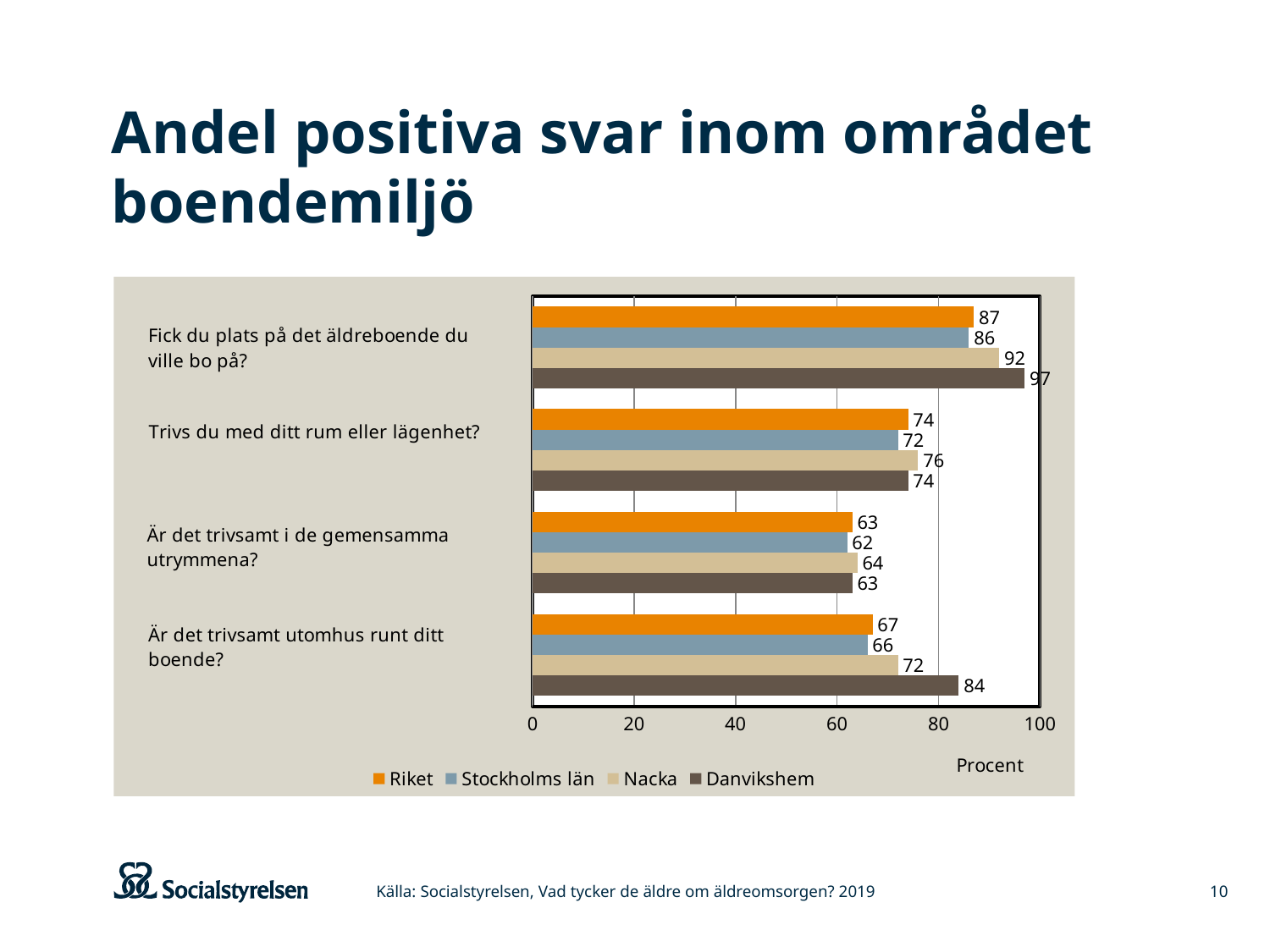
What kind of chart is shown on the slide? bar chart Is the value for Danvikshem on "Är det trivsamt i de gemensamma utrymmena?" greater or less than 80? less What is the difference between Danvikshem and Riket on "Är det trivsamt utomhus runt ditt boende?"? 17 How many series does the legend list? 4 Which is larger on "Trivs du med ditt rum eller lägenhet?": Nacka or Stockholms län? Nacka What is the value for Stockholms län on "Trivs du med ditt rum eller lägenhet?"? 72 How many questions (categories) are shown on the chart? 4 Which series has the highest value on "Är det trivsamt utomhus runt ditt boende?"? Danvikshem What is the value for Nacka on "Är det trivsamt utomhus runt ditt boende?"? 72 Which series has the lowest value on "Fick du plats på det äldreboende du ville bo på?"? Stockholms län What is the value for Danvikshem on "Fick du plats på det äldreboende du ville bo på?"? 97 What is the value for Riket on "Är det trivsamt i de gemensamma utrymmena?"? 63